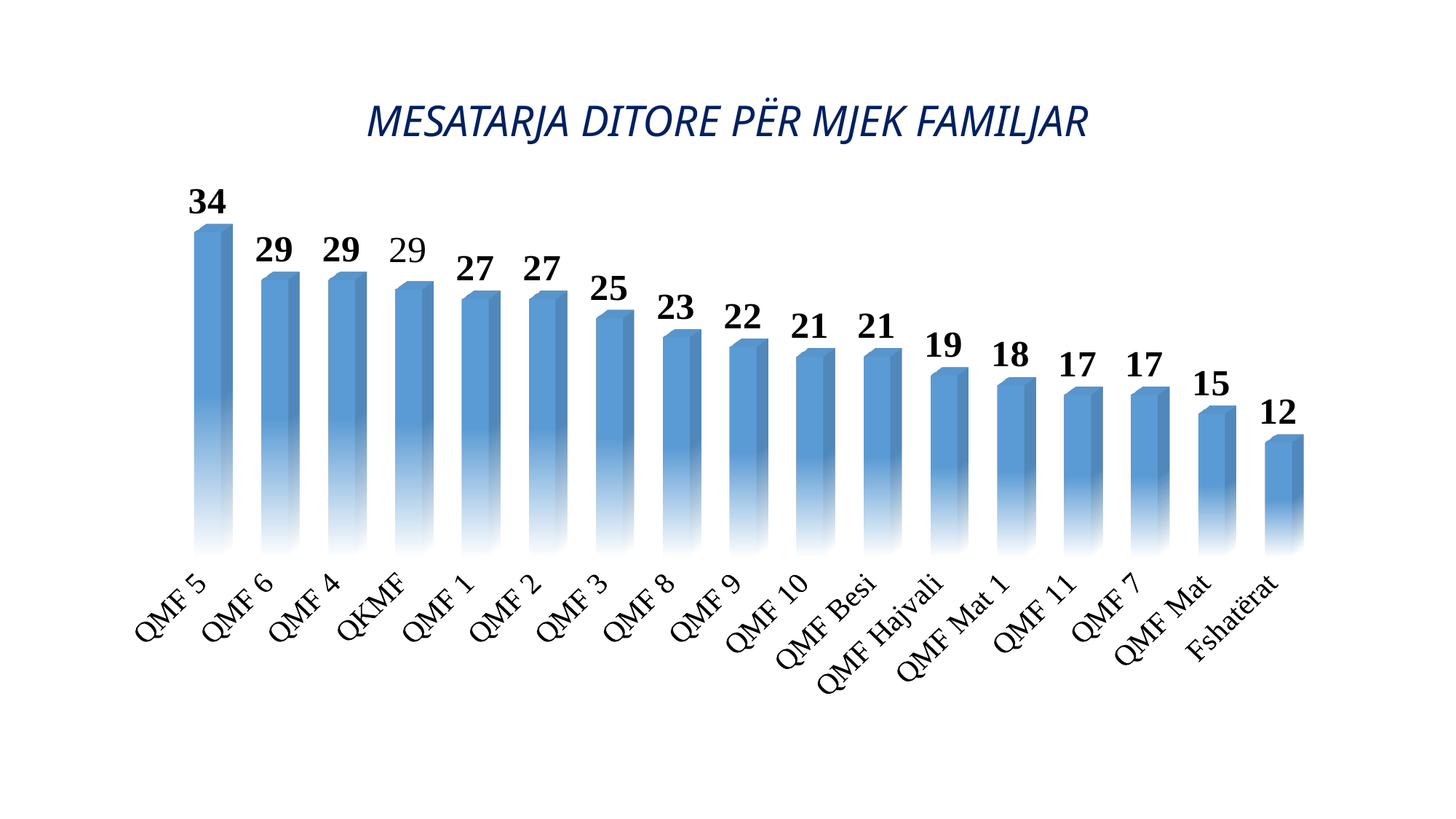
Which is larger, the value for QMF 8 or the value for QMF Besi? QMF 8 What is the value for QMF Mat? 15 What is the difference between the values for QMF 5 and Fshatërat? 22 Do the values rise or fall from left to right along the x axis? fall What is the value for QMF Hajvali? 19 What is the difference between the values for QMF 3 and QMF 10? 4 What is the value for QMF 5? 34 Which category has the highest value? QMF 5 How many categories are shown in the chart? 17 What is the title of the chart? MESATARJA DITORE PËR MJEK FAMILJAR Which category has the lowest value? Fshatërat What kind of chart is shown on the slide? bar chart